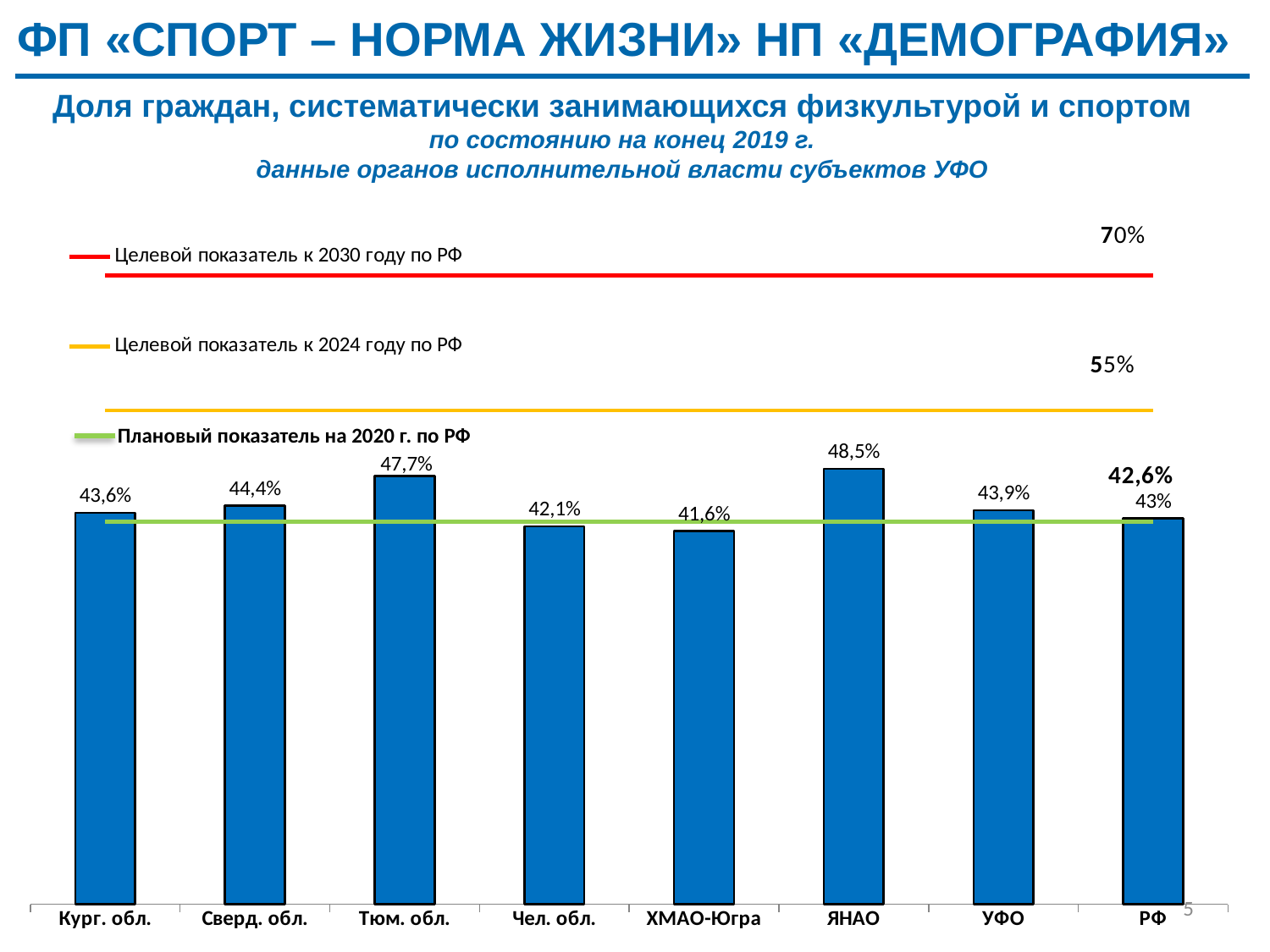
Which is larger, the value for Сверд. обл. or the value for Кург. обл.? Сверд. обл. What is the value for УФО? 43,9% Which category has the lowest bar? ХМАО-Югра What is the value for Тюм. обл.? 47,7% What is the value for ХМАО-Югра? 41,6% What value is shown for the target indicator for 2024 (Целевой показатель к 2024 году по РФ)? 55% What is the difference between the values for ЯНАО and ХМАО-Югра? 6,9% What is the difference between the values for Тюм. обл. and Чел. обл.? 5,6% How many categories are shown on the x axis? 8 Which category has the highest bar? ЯНАО What kind of chart is this? combination bar and line chart What value is shown for the target indicator for 2030 (Целевой показатель к 2030 году по РФ)? 70%